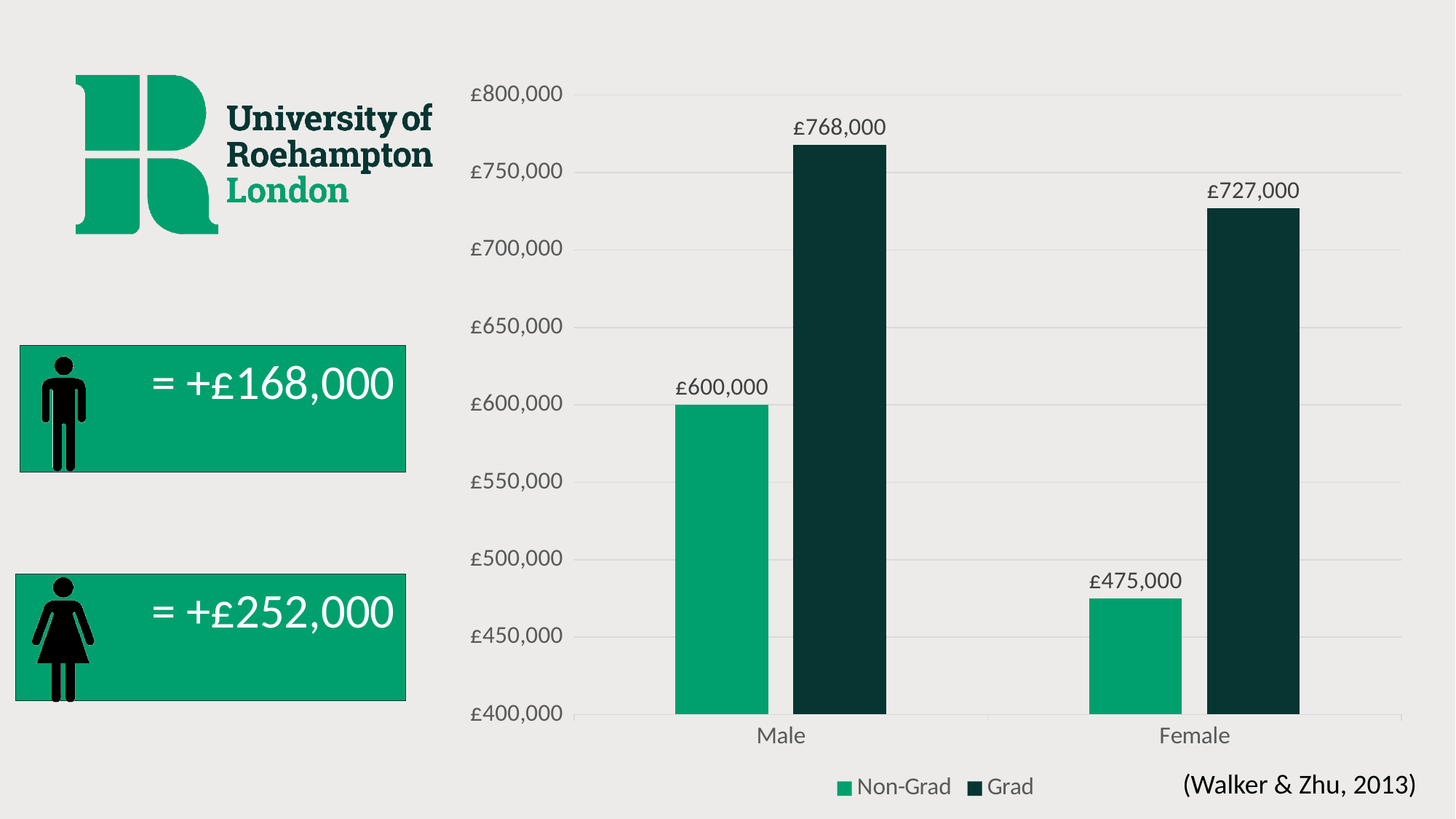
What is the Non-Grad value for Male? £600,000 What is the Grad value for Male? £768,000 What kind of chart is shown on the slide? Bar chart What is the Grad value for Female? £727,000 How many series does the legend list? 2 Which bar has the lowest value on the chart? Female Non-Grad What is the Non-Grad value for Female? £475,000 How many categories are shown on the x axis? 2 What is the difference between the Grad and Non-Grad values for Female? £252,000 What is the difference between the Grad and Non-Grad values for Male? £168,000 Which is larger, the Grad value for Male or the Grad value for Female? Grad value for Male Which bar has the highest value on the chart? Male Grad